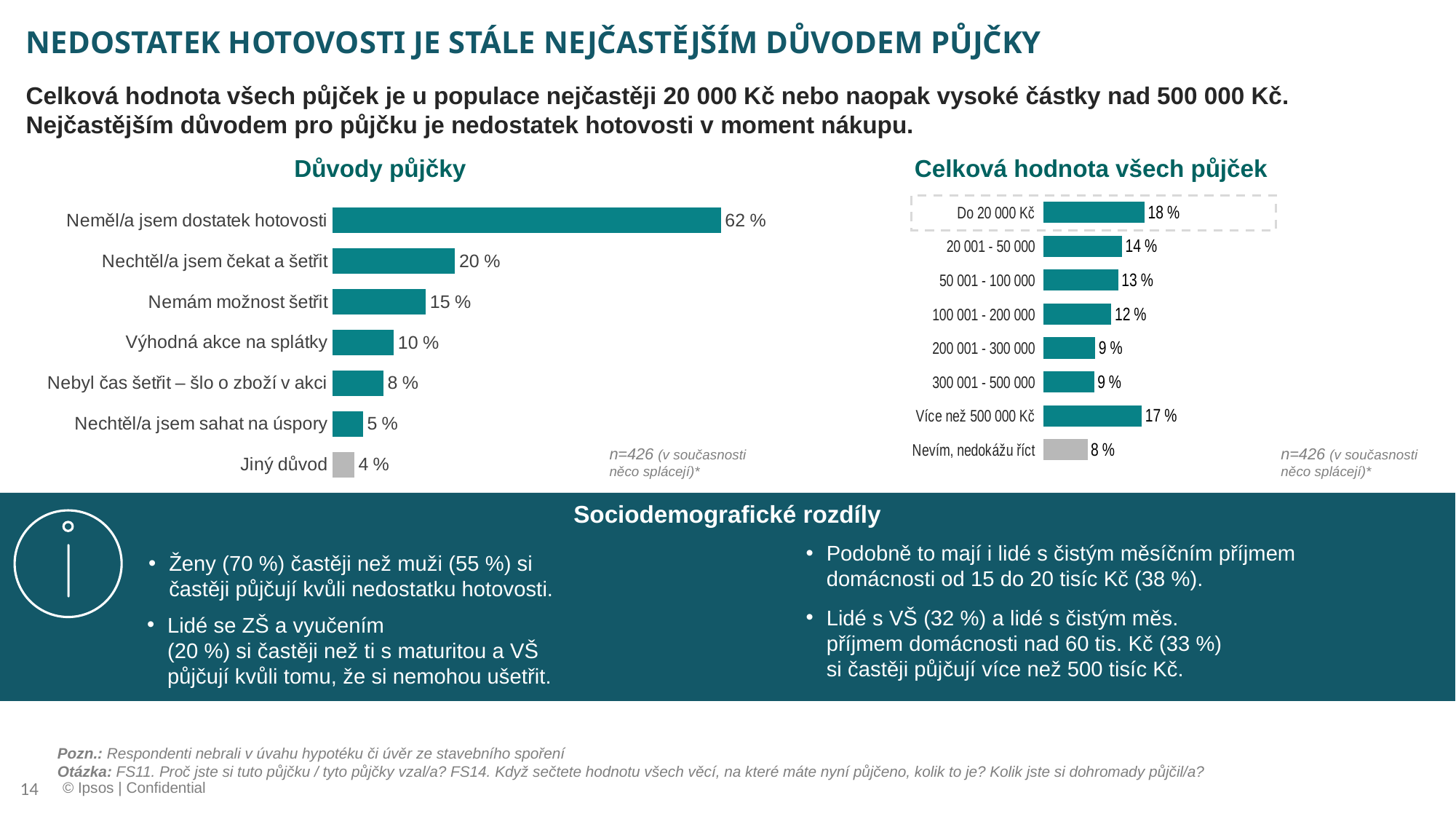
In the 'Celková hodnota všech půjček' chart, which category has the highest value? Do 20 000 Kč In the 'Důvody půjčky' chart, which category has the lowest value? Jiný důvod In the 'Celková hodnota všech půjček' chart, what is the value for '100 001 - 200 000'? 12 % What type of chart is the 'Důvody půjčky' chart? Bar chart In the 'Důvody půjčky' chart, how many categories are shown? 7 In the 'Celková hodnota všech půjček' chart, what is the value for 'Více než 500 000 Kč'? 17 % In the 'Celková hodnota všech půjček' chart, how many categories are shown? 8 In the 'Celková hodnota všech půjček' chart, what is the difference between 'Do 20 000 Kč' and '20 001 - 50 000'? 4 % In the 'Celková hodnota všech půjček' chart, which category is drawn in grey instead of teal? Nevím, nedokážu říct In the 'Důvody půjčky' chart, what is the value for 'Neměl/a jsem dostatek hotovosti'? 62 % In the 'Důvody půjčky' chart, which is larger: 'Výhodná akce na splátky' or 'Nechtěl/a jsem sahat na úspory'? Výhodná akce na splátky In the 'Důvody půjčky' chart, what is the difference between 'Nechtěl/a jsem čekat a šetřit' and 'Nemám možnost šetřit'? 5 %